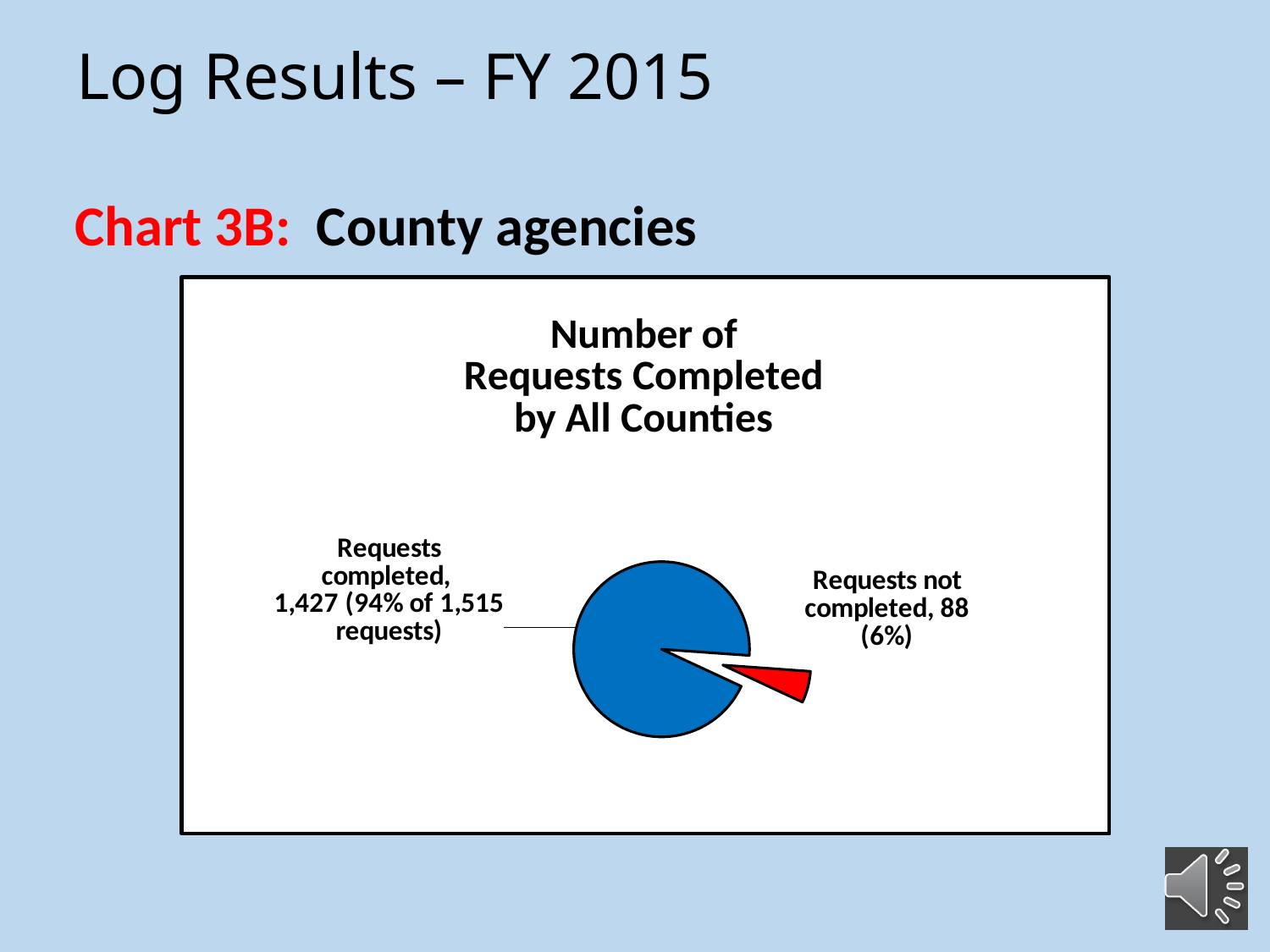
How many requests were not completed? 88 What colour is the slice for requests not completed? red Which slice is larger: requests completed or requests not completed? Requests completed How many slices does the pie chart have? 2 What share of the pie do requests not completed represent? 6% What is the difference between the number of requests completed and the number not completed? 1,339 Which category has the smallest slice of the pie? Requests not completed What is the chart's title? Number of Requests Completed by All Counties How many requests were completed by all counties? 1,427 What type of chart is shown on the slide? pie chart What share of the pie do completed requests represent? 94% What is the total number of requests shown in the chart? 1,515